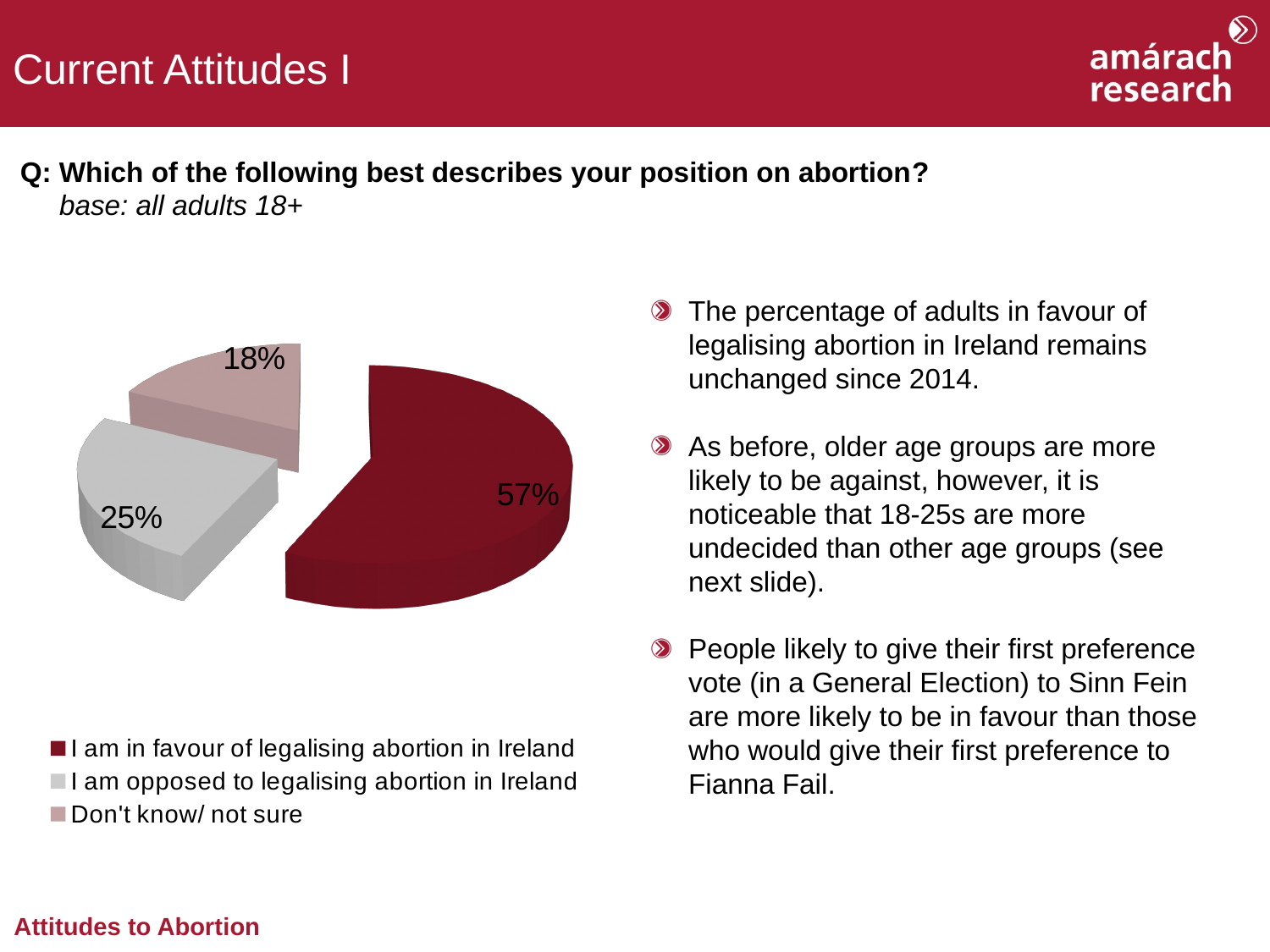
What percentage of adults are in favour of legalising abortion in Ireland? 57% What percentage of adults are opposed to legalising abortion in Ireland? 25% Which response has the largest share of the pie? I am in favour of legalising abortion in Ireland What is the difference in percentage points between those opposed and those who don't know/ not sure? 7 How many entries does the legend list? 3 Which colour represents 'I am in favour of legalising abortion in Ireland' in the pie chart? dark red How many slices does the pie chart have? 3 Which response has the smallest share of the pie? Don't know/ not sure What kind of chart is shown on the slide? pie chart Which is larger: the share opposed to legalising abortion or the share who don't know/ not sure? I am opposed to legalising abortion in Ireland What percentage of adults answered 'Don't know/ not sure'? 18% What is the difference in percentage points between those in favour and those opposed? 32